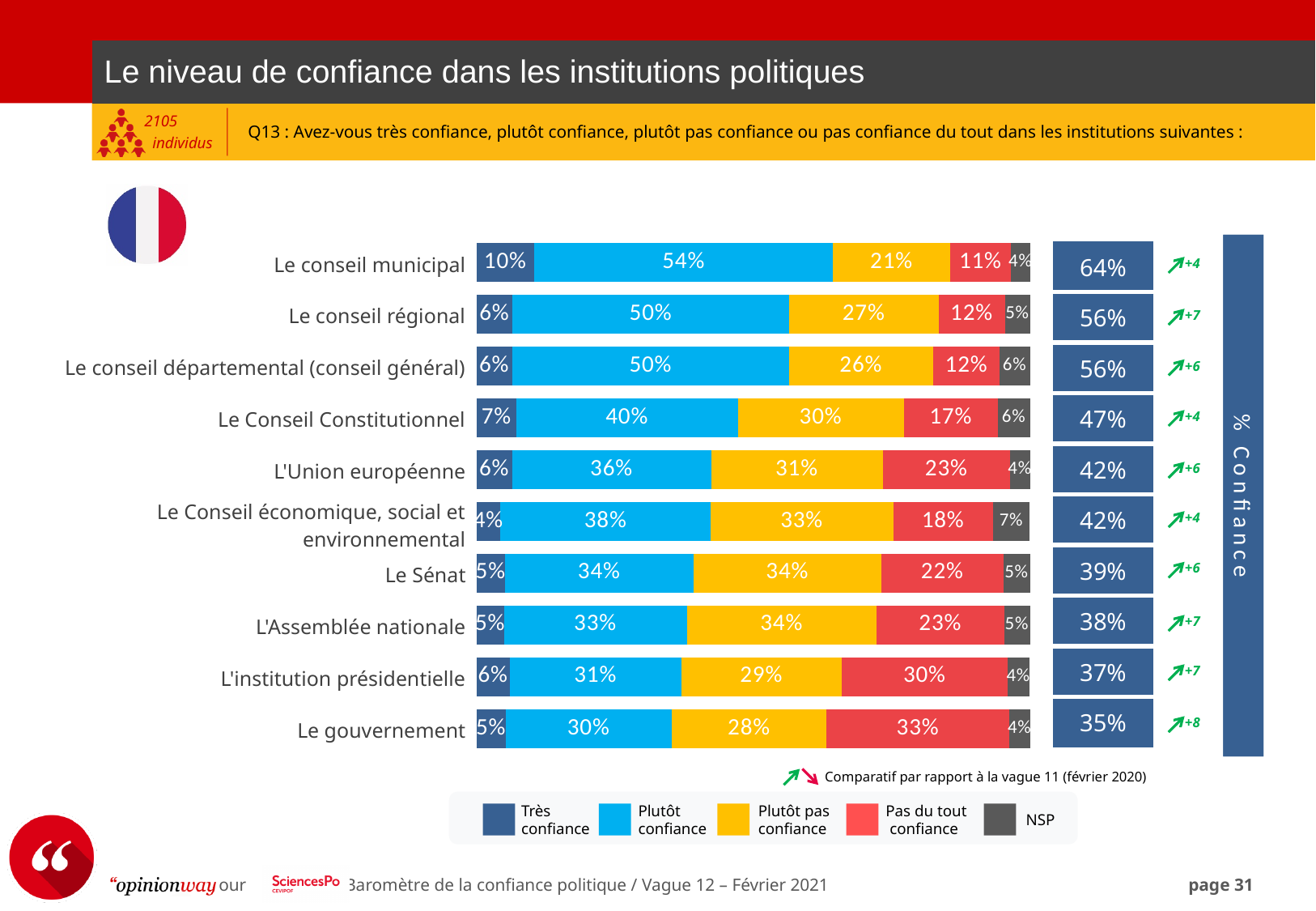
Which institution has the highest "% Confiance" total? Le conseil municipal How many institutions are listed in the chart? 10 What percentage of respondents answered "Plutôt confiance" for Le conseil municipal? 54% What is the "Pas du tout confiance" value for Le gouvernement? 33% Which has a larger "Pas du tout confiance" share: L'institution présidentielle or Le Sénat? L'institution présidentielle What is the "% Confiance" total shown for Le Conseil Constitutionnel? 47% What is the difference between the "Plutôt confiance" values for Le conseil municipal and Le gouvernement? 24 percentage points What type of chart is shown on the slide? Stacked bar chart What is the change versus wave 11 shown next to Le gouvernement? +8 How many response categories does the legend list? 5 What is the combined "Très confiance" and "Plutôt confiance" total for Le conseil régional? 56% Which institution has the lowest "% Confiance" total? Le gouvernement